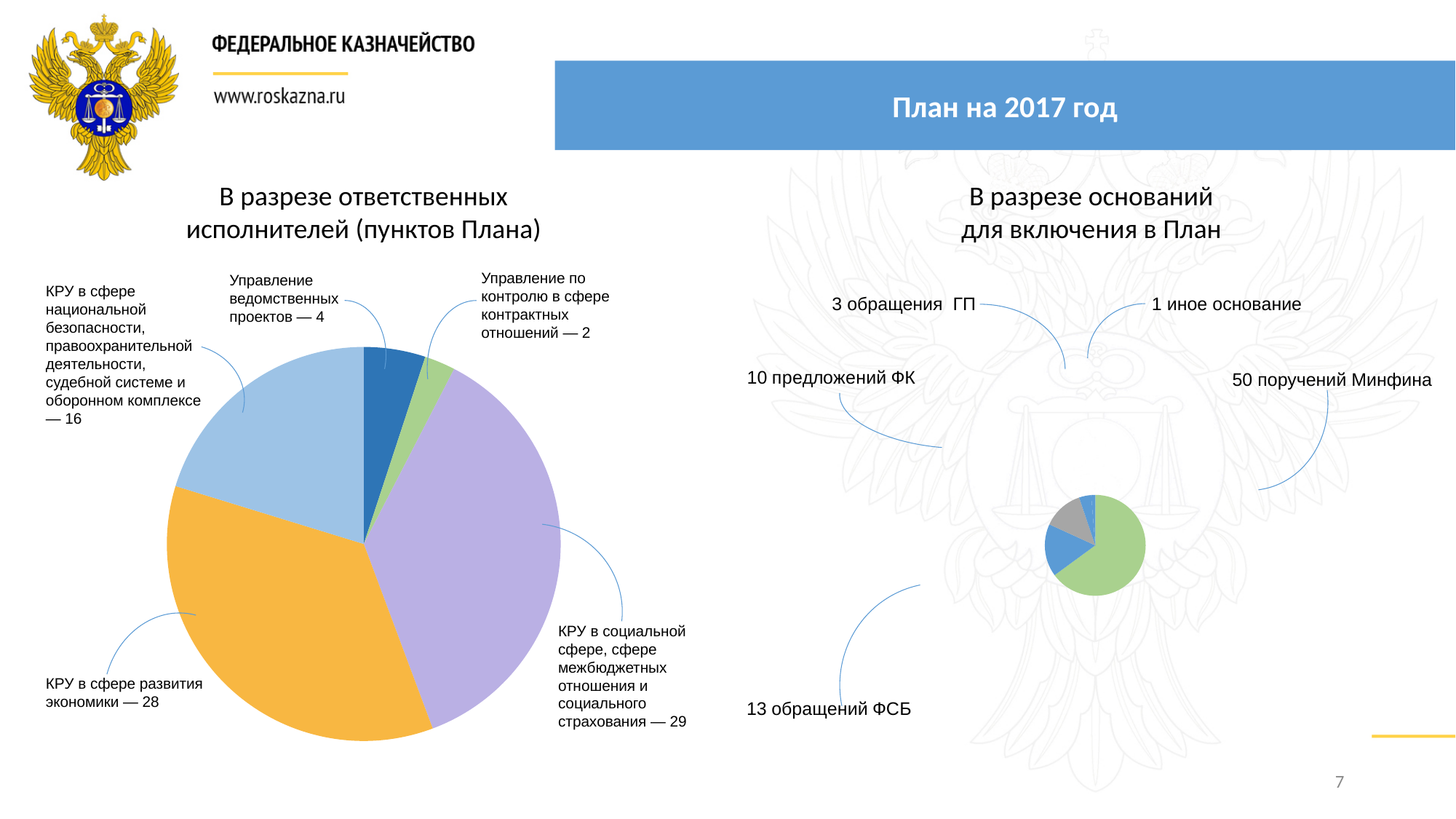
What kind of chart is the left chart, 'В разрезе ответственных исполнителей (пунктов Плана)'? pie chart In the right chart 'В разрезе оснований для включения в План', which is larger: обращений ФСБ or обращения ГП? обращений ФСБ In the right chart 'В разрезе оснований для включения в План', which basis has the largest value? поручения Минфина In the right chart 'В разрезе оснований для включения в План', which basis has the smallest value? иное основание In the left chart 'В разрезе ответственных исполнителей', what is the total number of plan items across all executors? 79 In the right chart 'В разрезе оснований для включения в План', what is the difference between обращений ФСБ and предложений ФК? 3 In the left chart 'В разрезе ответственных исполнителей', which executor has the largest number of plan items? КРУ в социальной сфере, сфере межбюджетных отношения и социального страхования In the left chart 'В разрезе ответственных исполнителей', how many more plan items does КРУ в сфере национальной безопасности have than Управление ведомственных проектов? 12 In the right chart 'В разрезе оснований для включения в План', how many поручений Минфина are there? 50 In the left chart 'В разрезе ответственных исполнителей', how many plan items are assigned to КРУ в сфере развития экономики? 28 In the left chart 'В разрезе ответственных исполнителей', which executor has the smallest number of plan items? Управление по контролю в сфере контрактных отношений How many slices does the left chart 'В разрезе ответственных исполнителей' have? 5